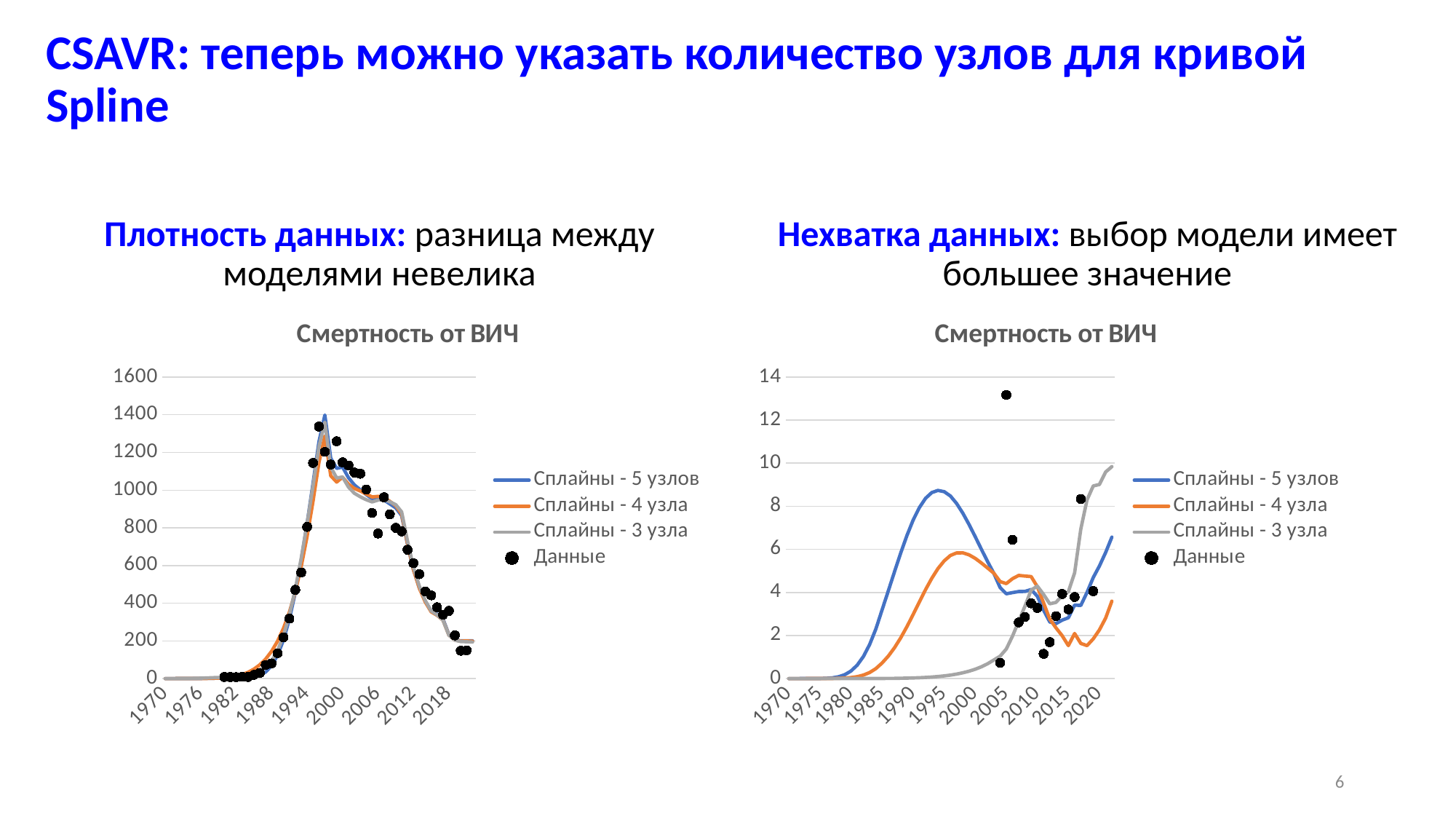
What is the title of the chart on the left side of the slide? Смертность от ВИЧ In the right chart, does the 'Сплайны - 3 узла' line rise or fall between 2005 and 2020? rise In the left chart, is the value of the 'Данные' point at 1982 greater or less than 200? less In the right chart, what colour is the 'Сплайны - 4 узла' line? orange How many entries does the legend of the left chart list? 4 In the right chart, which line is higher at 1995: 'Сплайны - 5 узлов' or 'Сплайны - 4 узла'? Сплайны - 5 узлов In the right chart, is the value of the 'Сплайны - 3 узла' line at 2020 greater or less than 8? greater In the right chart, is the highest 'Данные' point greater or less than 12? greater In the left chart, do the 'Данные' points rise or fall between 2006 and 2018? fall What kind of chart is the right chart on the slide? line chart